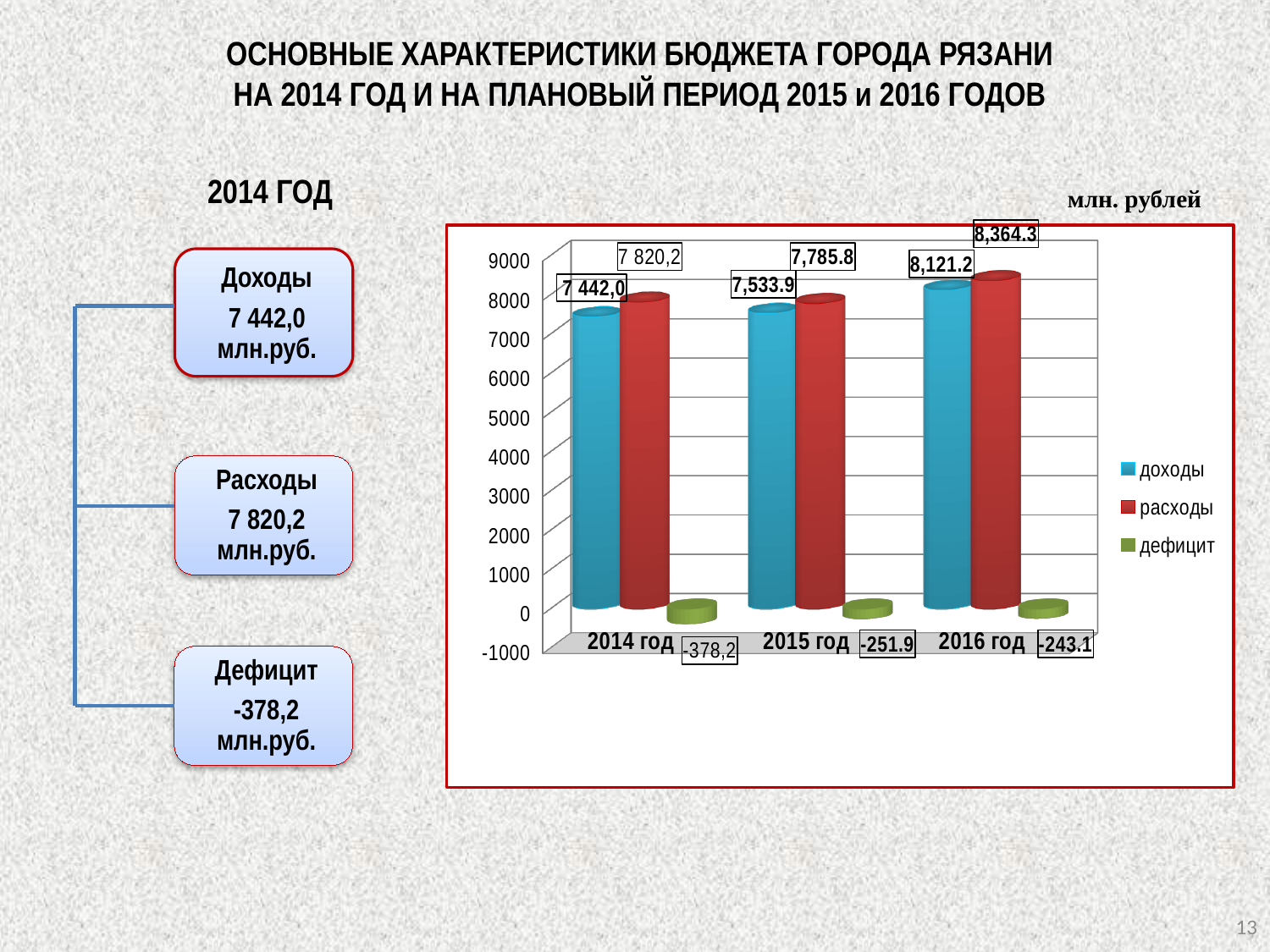
What kind of chart is shown on the slide? bar chart What is the difference between расходы and доходы in 2016 год? 243.1 Do the values for доходы rise or fall from 2014 год to 2016 год? rise What is the value for расходы in 2016 год? 8,364.3 In which year is the value for доходы highest? 2016 год Which is larger in 2015 год: доходы or расходы? расходы What is the value for дефицит in 2015 год? -251.9 In which year is the value for дефицит lowest? 2014 год What is the value for расходы in 2015 год? 7,785.8 How many series does the legend list? 3 What is the value for доходы in 2014 год? 7 442,0 How many years (categories) are shown on the x axis? 3